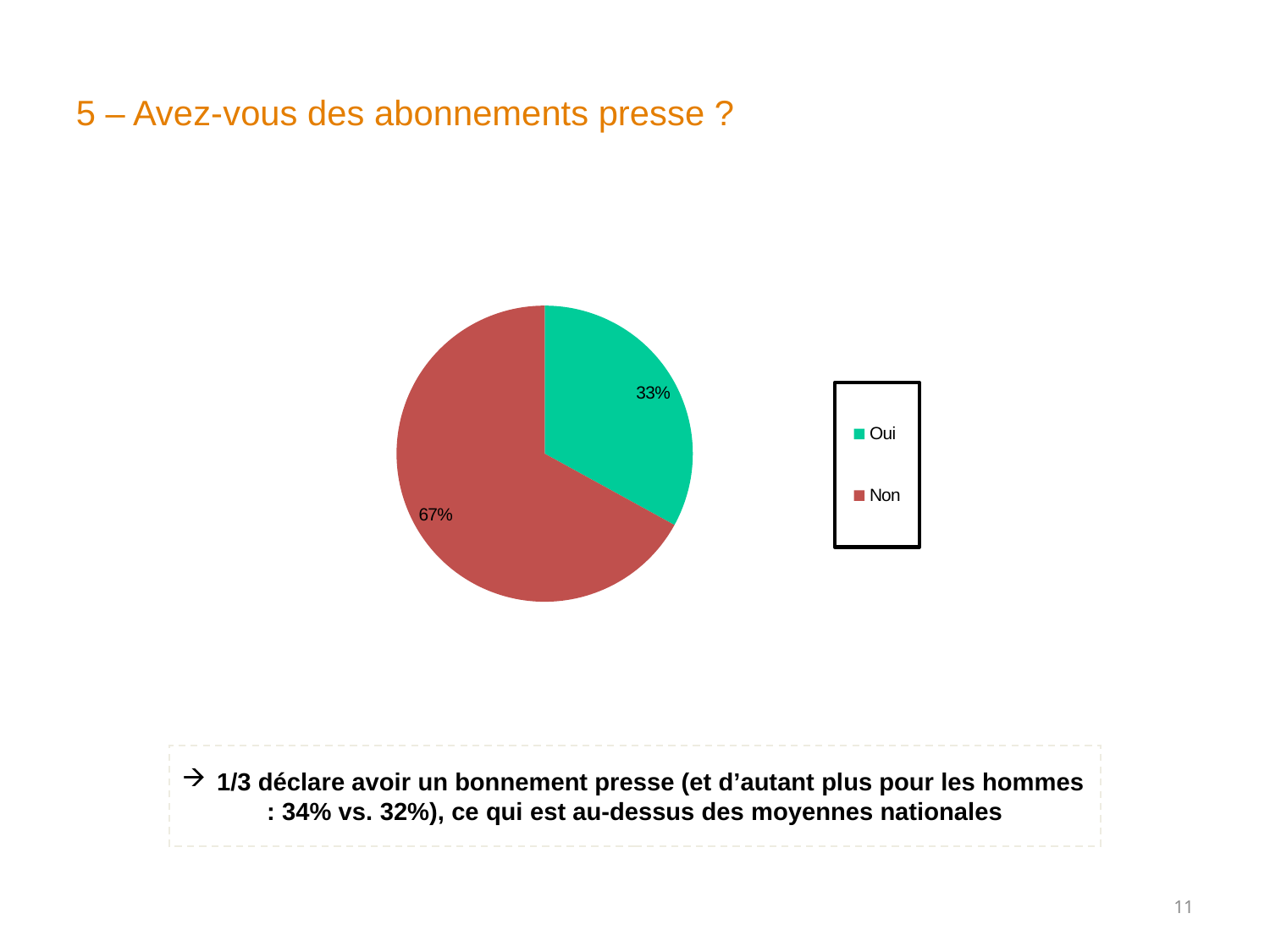
How many slices does the pie chart have? 2 What colour is the "Non" slice in the pie chart? Red What is the difference in percentage points between the "Non" slice and the "Oui" slice? 34 Which is larger, the "Oui" slice or the "Non" slice? Non What percentage of the pie chart is labelled "Non"? 67% Which slice of the pie chart is the smallest? Oui What kind of chart is shown on the slide? Pie chart Which slice of the pie chart is the largest? Non How many entries does the legend list? 2 What share of the pie does the "Oui" slice represent? 33% What is the title of the slide containing the pie chart? 5 – Avez-vous des abonnements presse ? What percentage of the pie chart is labelled "Oui"? 33%